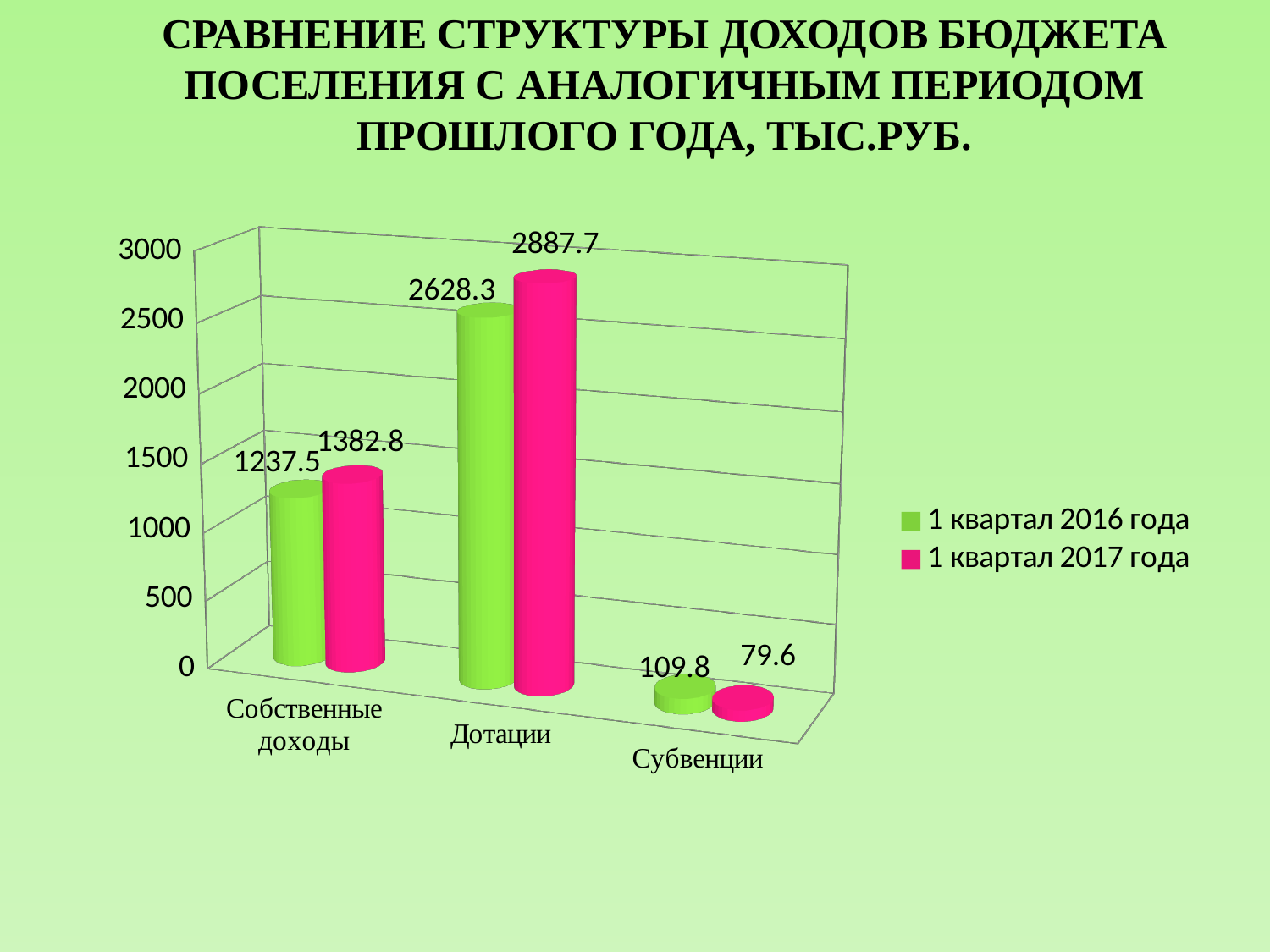
Which category has the lowest value in the 1 квартал 2016 года series? Субвенции What is the value for Субвенции in the 1 квартал 2017 года series? 79.6 What is the value for Дотации in the 1 квартал 2017 года series? 2887.7 What is the difference between the 1 квартал 2017 года and 1 квартал 2016 года values for Дотации? 259.4 What is the value for Собственные доходы in the 1 квартал 2016 года series? 1237.5 For Субвенции, which series has the larger value: 1 квартал 2016 года or 1 квартал 2017 года? 1 квартал 2016 года What kind of chart is shown on the slide? Bar chart Which category has the highest value in the 1 квартал 2017 года series? Дотации How many series does the legend list? 2 What colour represents the 1 квартал 2017 года series? Pink How many categories are shown on the x axis? 3 What is the value for Субвенции in the 1 квартал 2016 года series? 109.8